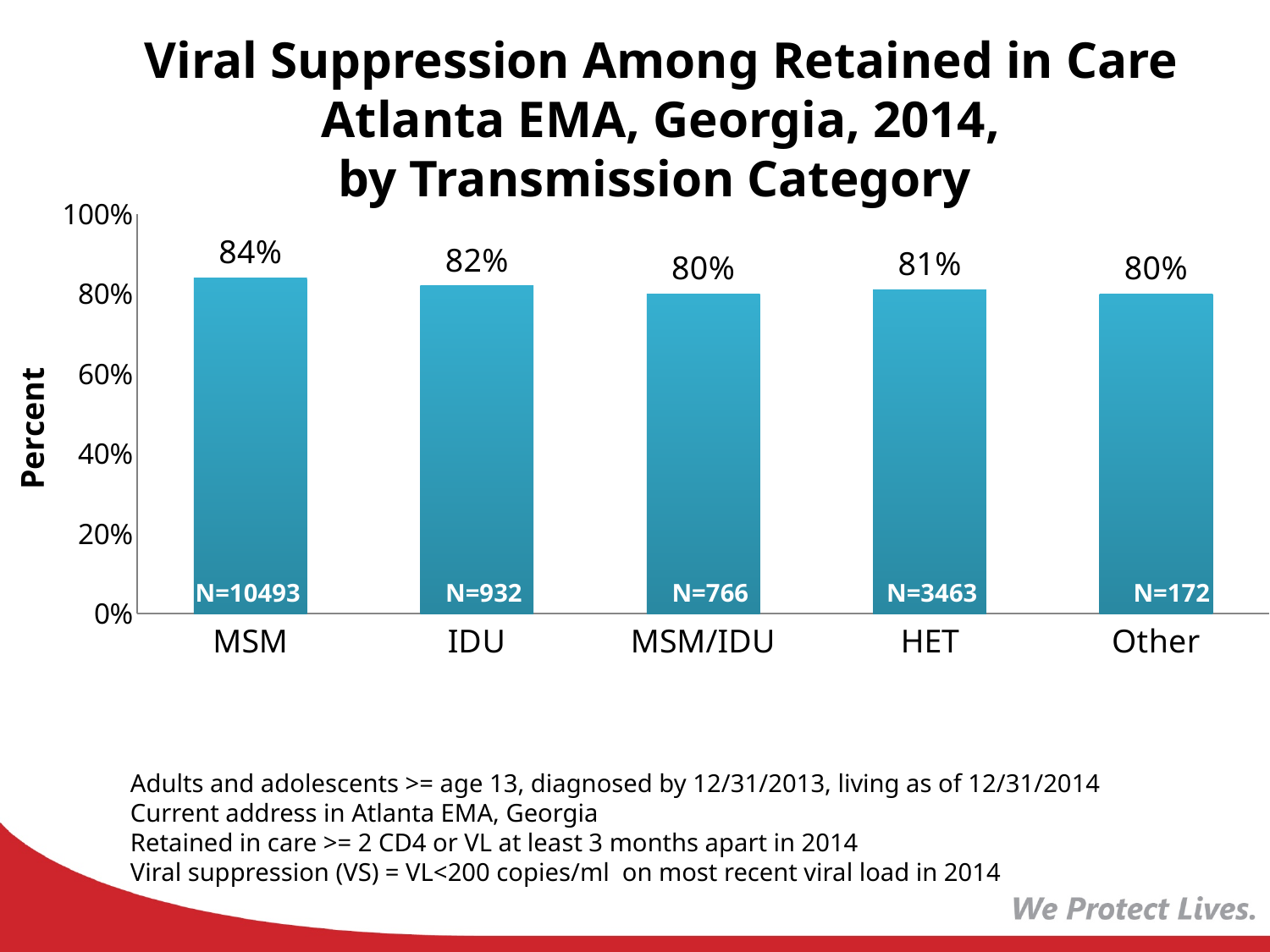
Which has a higher viral suppression percentage, MSM or MSM/IDU? MSM What is the viral suppression percentage for MSM? 84% What is the N value shown for the Other bar? N=172 What is the difference in viral suppression percentage between MSM and Other? 4% What is the viral suppression percentage for HET? 81% Which transmission category has the highest viral suppression percentage? MSM What is the difference in viral suppression percentage between IDU and HET? 1% What kind of chart is shown on the slide? Bar chart What is the viral suppression percentage for IDU? 82% What is the label on the vertical axis of the chart? Percent How many transmission categories are shown on the chart? 5 What is the N value shown for the HET bar? N=3463